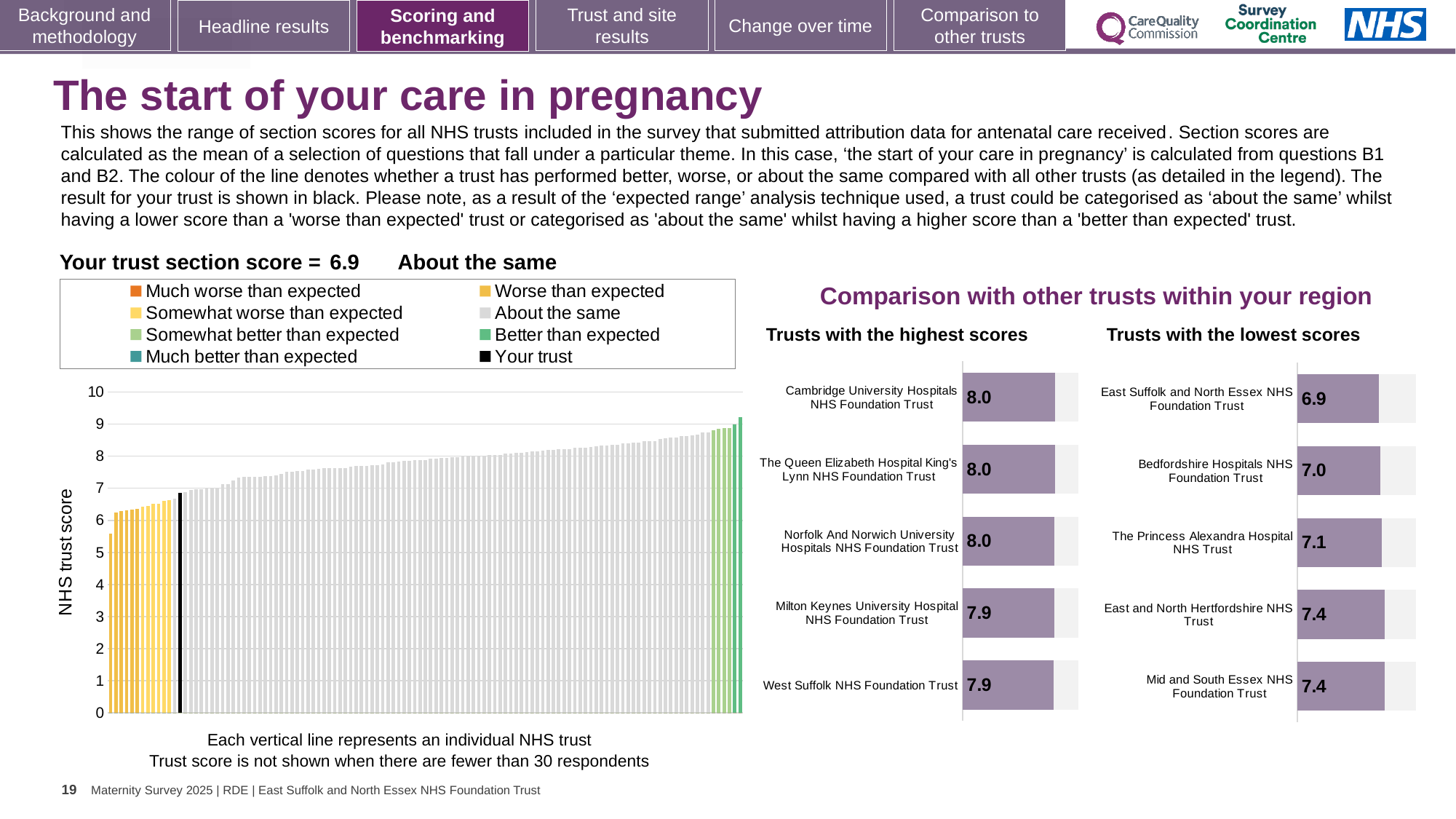
What type of chart is the 'NHS trust score' chart on the left of the slide? Bar chart In the 'Trusts with the lowest scores' chart, what is the difference between the scores of Mid and South Essex NHS Foundation Trust and East Suffolk and North Essex NHS Foundation Trust? 0.5 In the 'Trusts with the lowest scores' chart, which trust has the lowest score? East Suffolk and North Essex NHS Foundation Trust How many entries does the legend above the 'NHS trust score' chart list? 8 In the 'Trusts with the highest scores' chart, what is the score for Cambridge University Hospitals NHS Foundation Trust? 8.0 In the 'NHS trust score' chart on the left, do the bar values rise or fall from left to right? Rise In the 'Trusts with the highest scores' chart, what is the score for West Suffolk NHS Foundation Trust? 7.9 In the 'Trusts with the lowest scores' chart, what is the score for The Princess Alexandra Hospital NHS Trust? 7.1 In the 'Trusts with the lowest scores' chart, which has the higher score: Bedfordshire Hospitals NHS Foundation Trust or The Princess Alexandra Hospital NHS Trust? The Princess Alexandra Hospital NHS Trust How many trusts are shown in the 'Trusts with the highest scores' chart? 5 In the 'NHS trust score' chart on the left, is the value of the leftmost bar greater or less than 6? less In the 'Trusts with the highest scores' chart, what is the difference between the scores of Cambridge University Hospitals NHS Foundation Trust and Milton Keynes University Hospital NHS Foundation Trust? 0.1